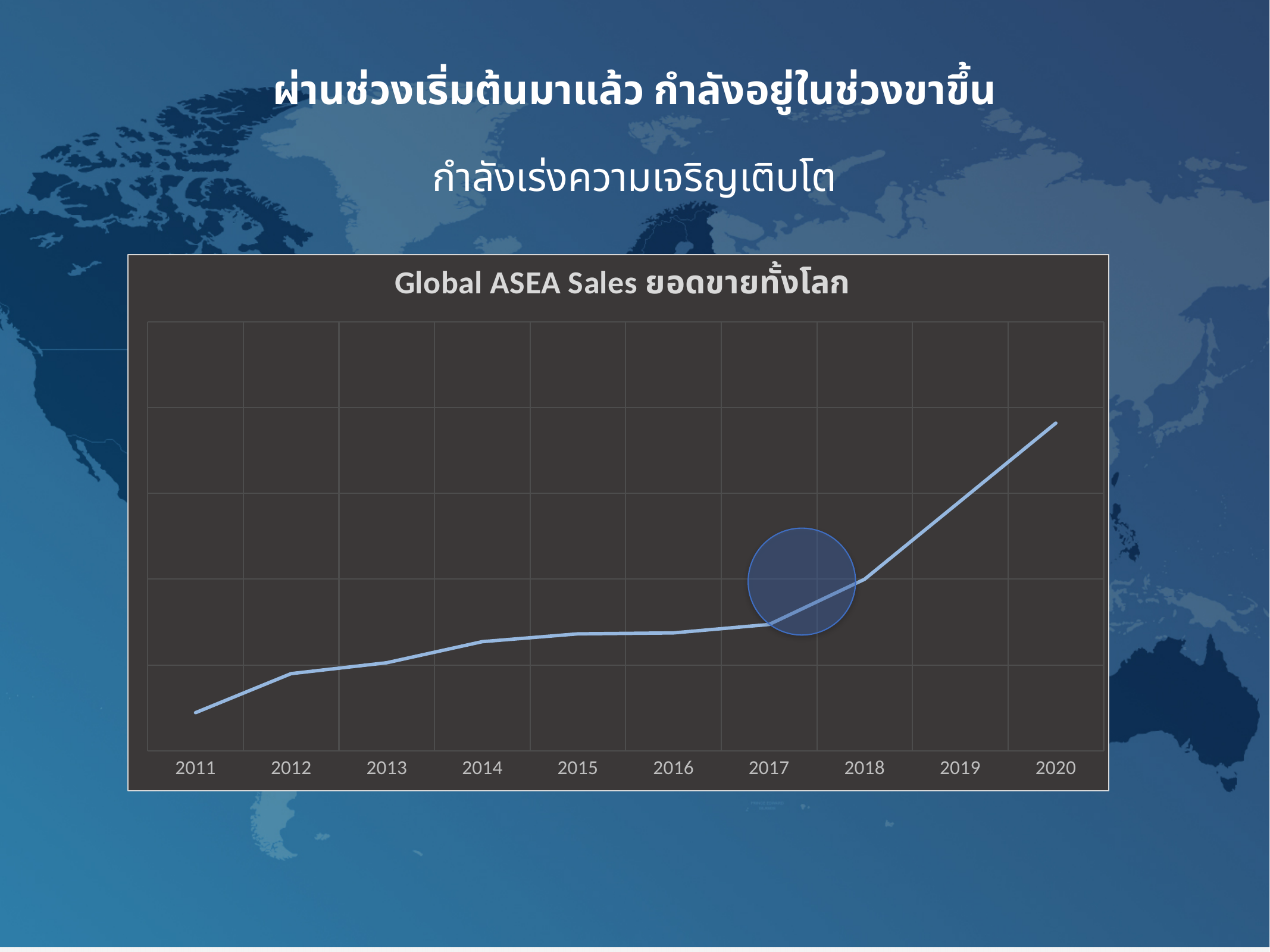
Do the values rise or fall from 2011 to 2020? rise Which year has the highest value on the chart? 2020 What is the title of the chart? Global ASEA Sales ยอดขายทั้งโลก Which year has the larger value, 2016 or 2020? 2020 Which year has the lowest value on the chart? 2011 What is the first year shown on the x axis? 2011 Which year has the larger value, 2018 or 2019? 2019 Does the line rise more steeply before 2018 or after 2018? after 2018 Which year has the larger value, 2011 or 2014? 2014 How many years are plotted along the x axis of the chart? 10 What kind of chart is shown on the slide? line chart